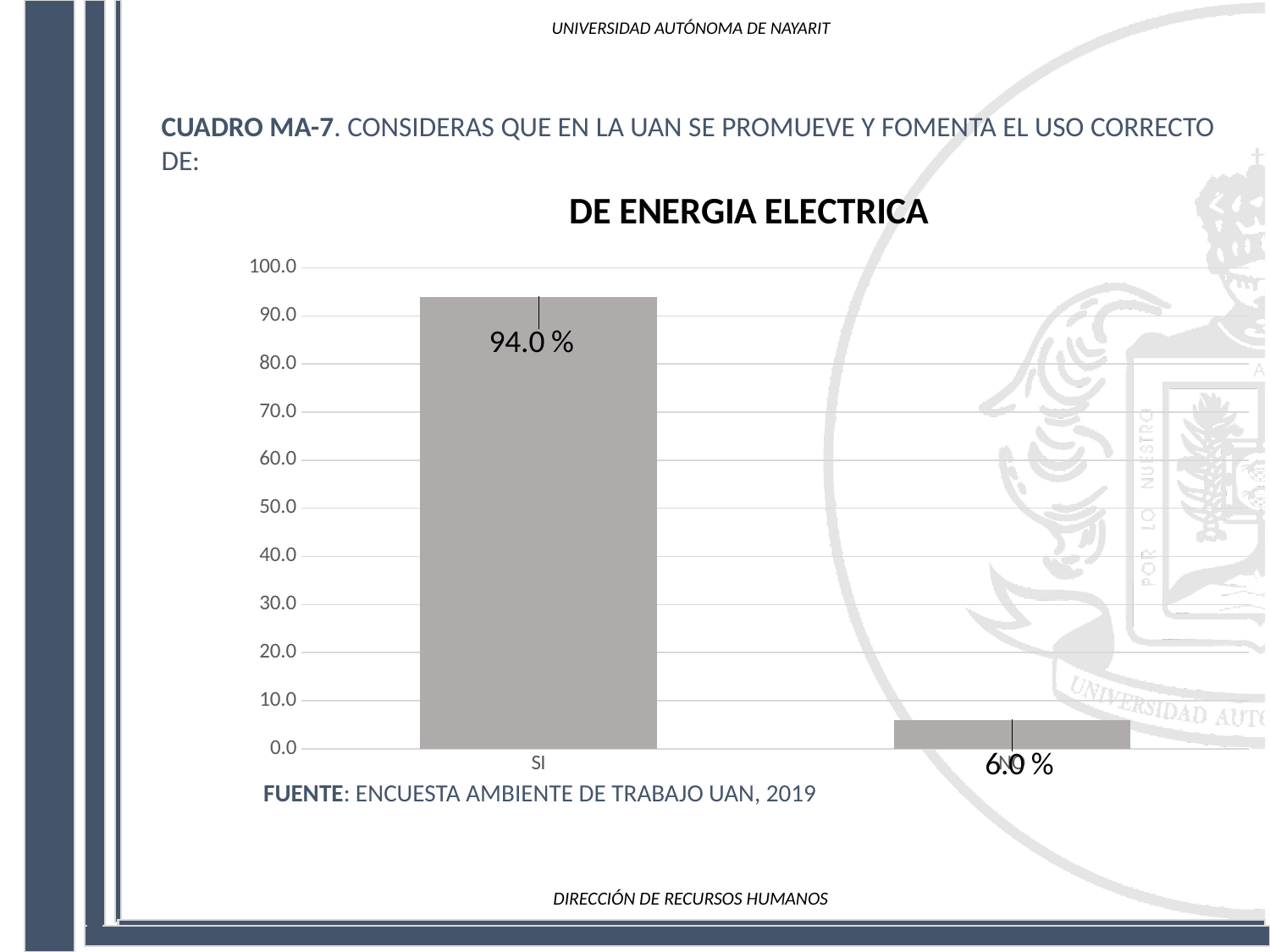
Which category has the highest value? SI What is the total of the two bar values? 100.0 % What is the value shown on the right-hand bar of the chart? 6.0 % Is the value of the right-hand bar greater or less than 10.0? less What is the maximum value shown on the vertical axis? 100.0 Which is larger, the SI bar or the right-hand bar? SI What is the value for the SI category? 94.0 % How many bars are plotted in the chart? 2 What type of chart is shown on the slide? bar chart What is the difference between the SI value and the right-hand bar's value? 88.0 % Is the value for SI greater or less than 90.0? greater What is the title of the chart? DE ENERGIA ELECTRICA